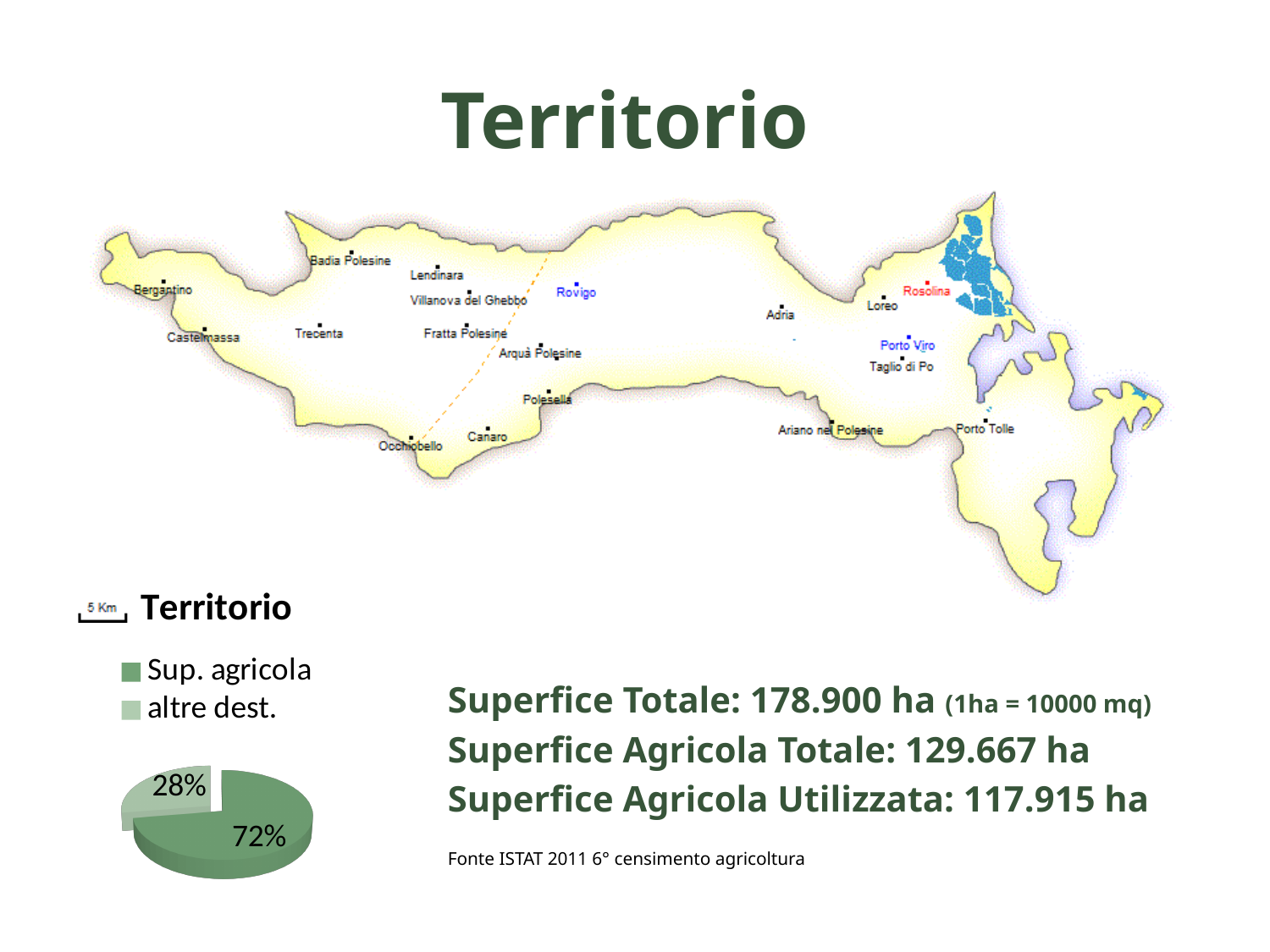
Is the share for altre dest. greater or less than 50%? less What share of the pie does Sup. agricola represent? 72% Which slice of the pie chart is the smallest? altre dest. Which slice of the pie chart is the largest? Sup. agricola What kind of chart is shown on the slide? pie chart How many entries does the legend of the pie chart list? 2 What share of the pie does altre dest. represent? 28% Which is larger in the pie chart, Sup. agricola or altre dest.? Sup. agricola What is the title of the pie chart? Territorio How many slices does the pie chart have? 2 What is the difference in percentage points between the Sup. agricola slice and the altre dest. slice? 44 Which legend entry is shown in the darker green colour? Sup. agricola